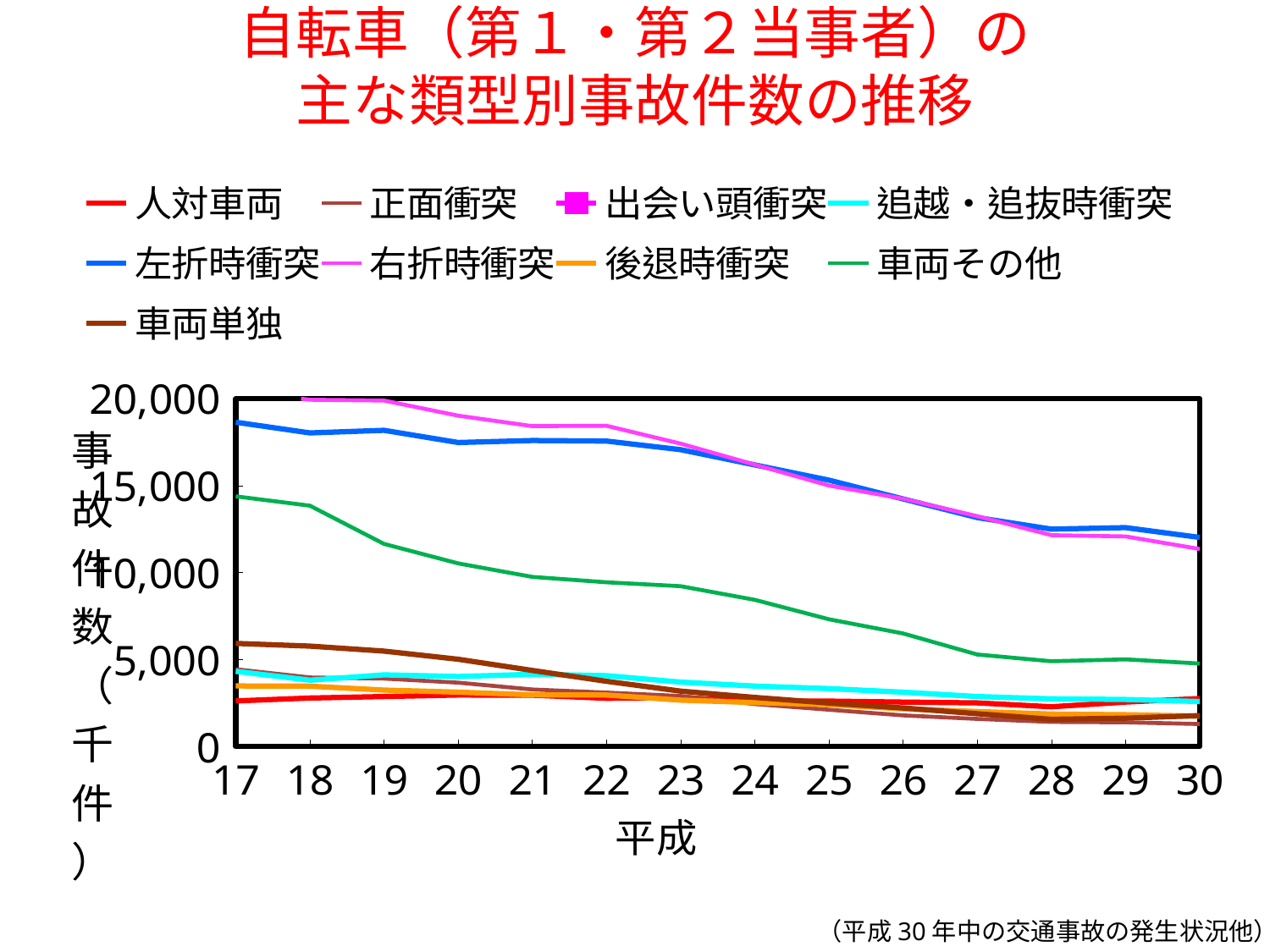
Does the value for 車両その他 rise or fall from 平成17 to 平成30? fall Is the value for 車両単独 in 平成30 greater or less than 5,000? less In 平成17, which is larger: 左折時衝突 or 車両その他? 左折時衝突 Is the value for 左折時衝突 in 平成30 greater or less than 15,000? less How many series does the legend list? 9 What is the label of the x axis? 平成 Is the value for 車両その他 in 平成19 greater or less than 10,000? greater What kind of chart is shown on the slide? line chart Does the value for 左折時衝突 rise or fall from 平成17 to 平成30? fall How many years (points) are shown along the x axis? 14